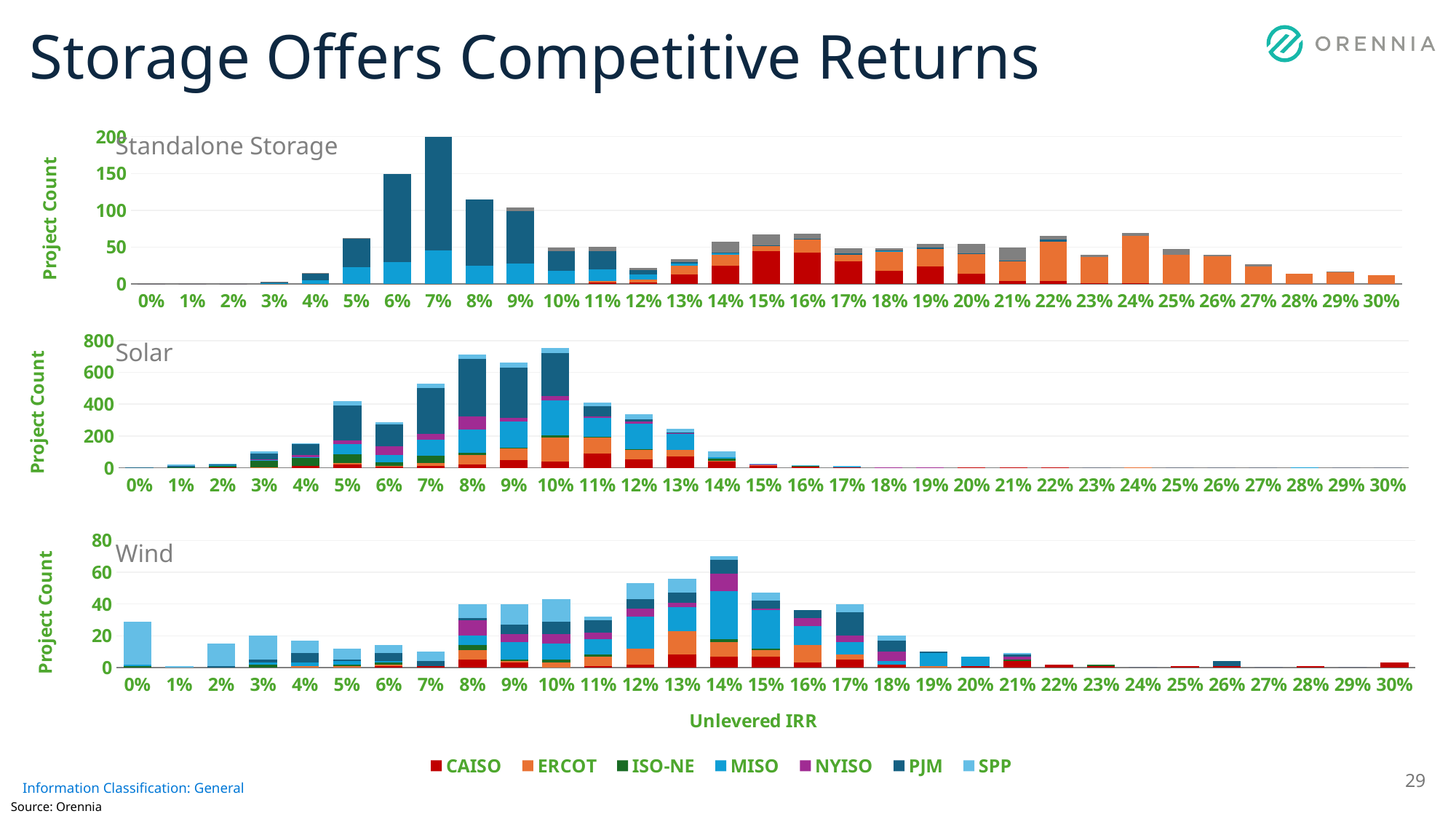
In the Solar chart, which has the larger total project count, 8% or 12%? 8% In the Wind chart, which IRR category has the highest project count? 14% In the Solar chart, which IRR category has the highest project count? 10% In the Standalone Storage chart, do the project counts rise or fall from 0% to 7%? rise In the Standalone Storage chart, is the total project count at 7% greater or less than 150? greater In the Solar chart, is the total project count at 10% greater or less than 600? greater In the Standalone Storage chart, which IRR category has the highest project count? 7% What is the title of the x axis shared by the charts? Unlevered IRR How many IRR categories are shown on the x axis of the Solar chart? 31 In the Wind chart, is the total project count at 1% greater or less than 20? less What kind of chart is the Standalone Storage chart? Stacked bar chart How many series does the legend list? 7